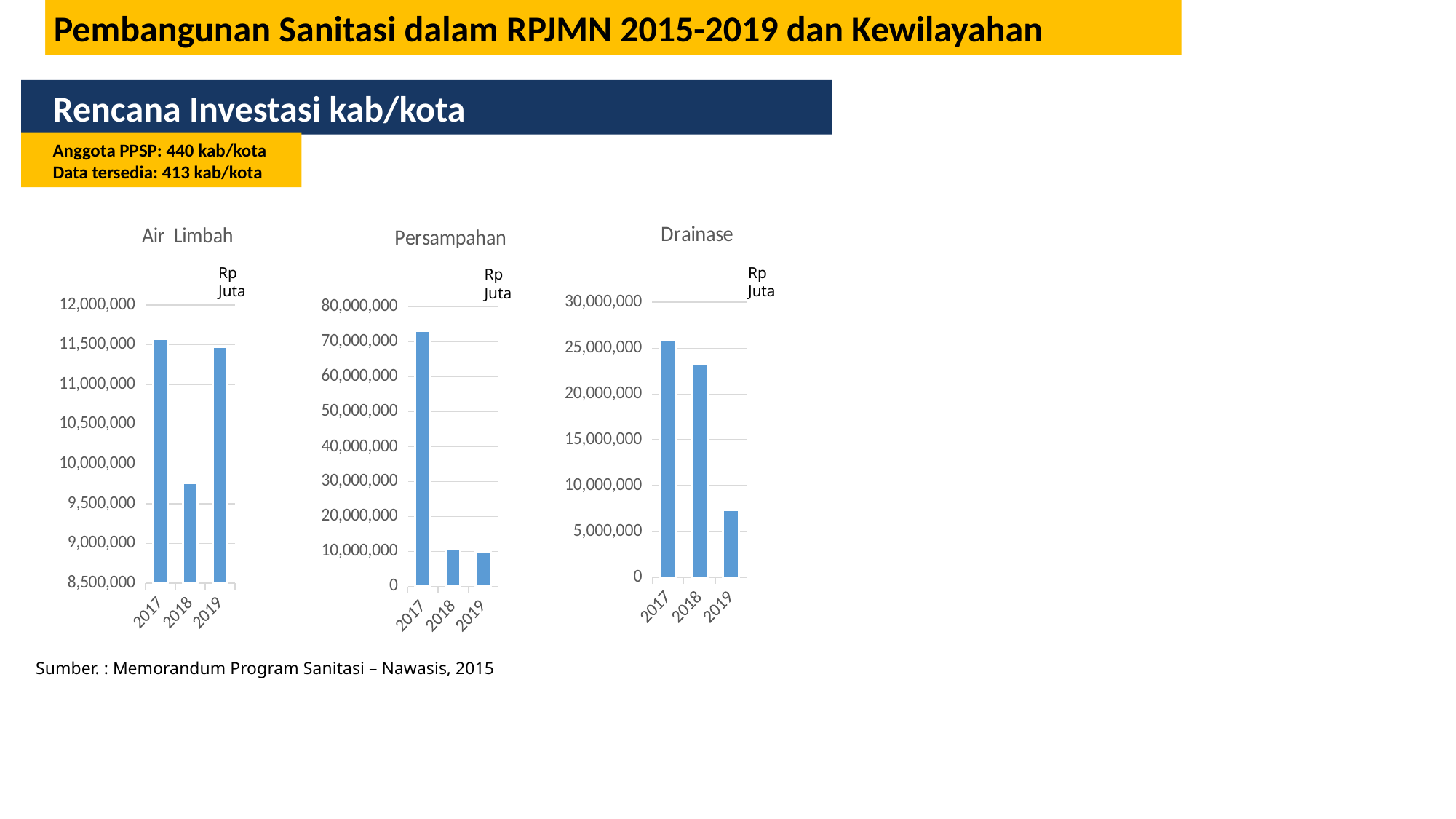
In the Persampahan chart, is the value for 2017 greater or less than 60,000,000? greater In the Drainase chart, which is larger, the value for 2017 or the value for 2018? 2017 In the Air Limbah chart, which year has the lowest value? 2018 In the Air Limbah chart, is the value for 2017 greater or less than 11,000,000? greater In the Persampahan chart, is the value for 2018 greater or less than 20,000,000? less In the Drainase chart, which year has the lowest value? 2019 How many years are shown on the Persampahan chart? 3 In the Persampahan chart, which year has the highest value? 2017 What kind of chart is the Air Limbah chart? bar chart What unit is shown on the y axis of the Drainase chart? Rp Juta In the Drainase chart, do the values rise or fall from 2017 to 2019? fall